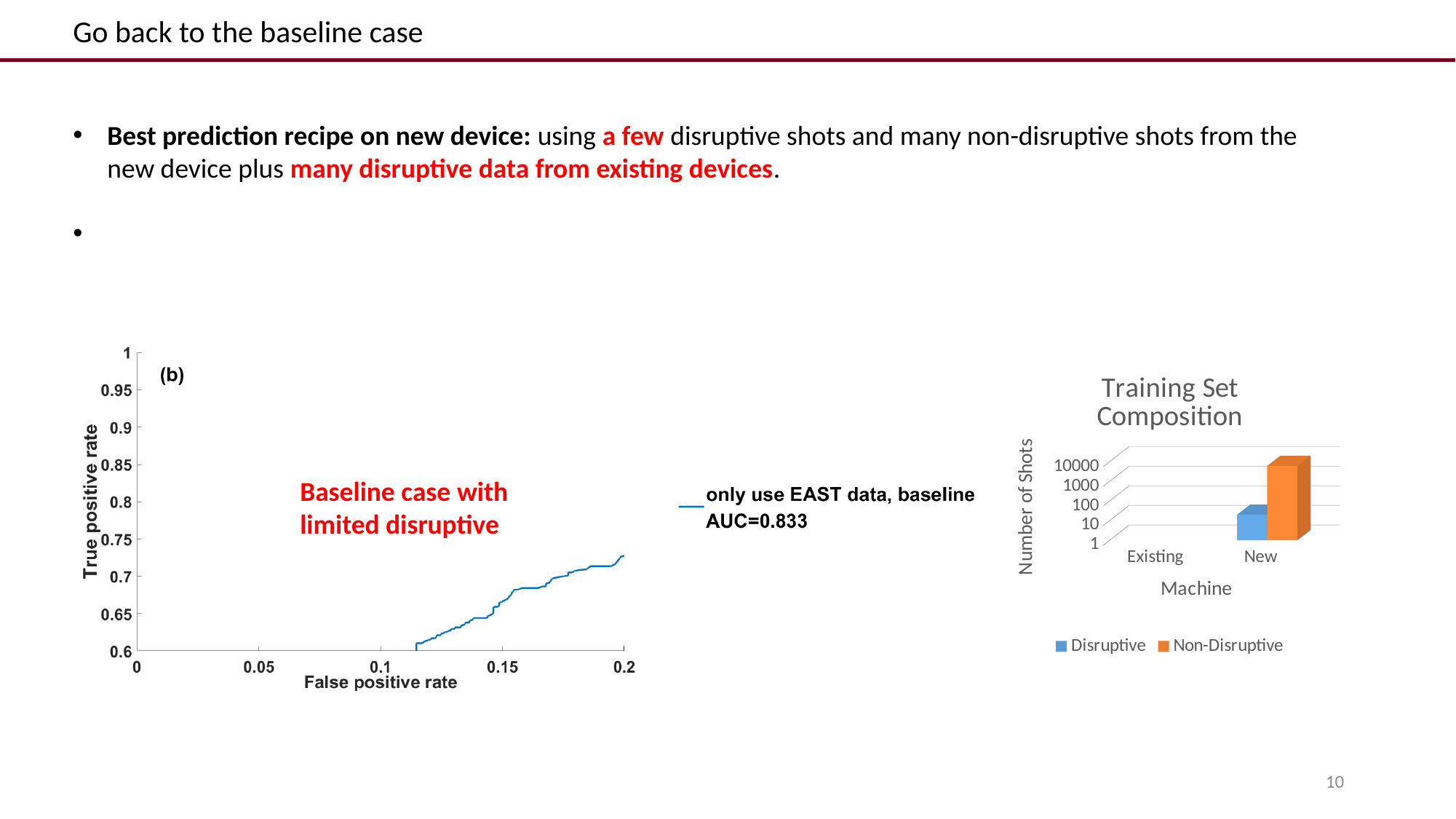
In the left chart, does the true positive rate rise or fall as the false positive rate increases? rise In the Training Set Composition chart, which series has the larger value for New: Disruptive or Non-Disruptive? Non-Disruptive In the Training Set Composition chart, is the Disruptive value for New greater or less than 100? less How many categories are shown on the Machine axis of the Training Set Composition chart? 2 In the left chart, is the true positive rate at a false positive rate of 0.2 greater or less than 0.7? greater What AUC value is given in the legend of the left chart? AUC=0.833 What kind of chart is the Training Set Composition chart? bar chart What kind of chart is the chart on the left with axes False positive rate and True positive rate? line chart In the Training Set Composition chart, which colour represents the Non-Disruptive series? orange How many series does the legend of the Training Set Composition chart list? 2 In the left chart, is the true positive rate at a false positive rate of 0.15 greater or less than 0.7? less